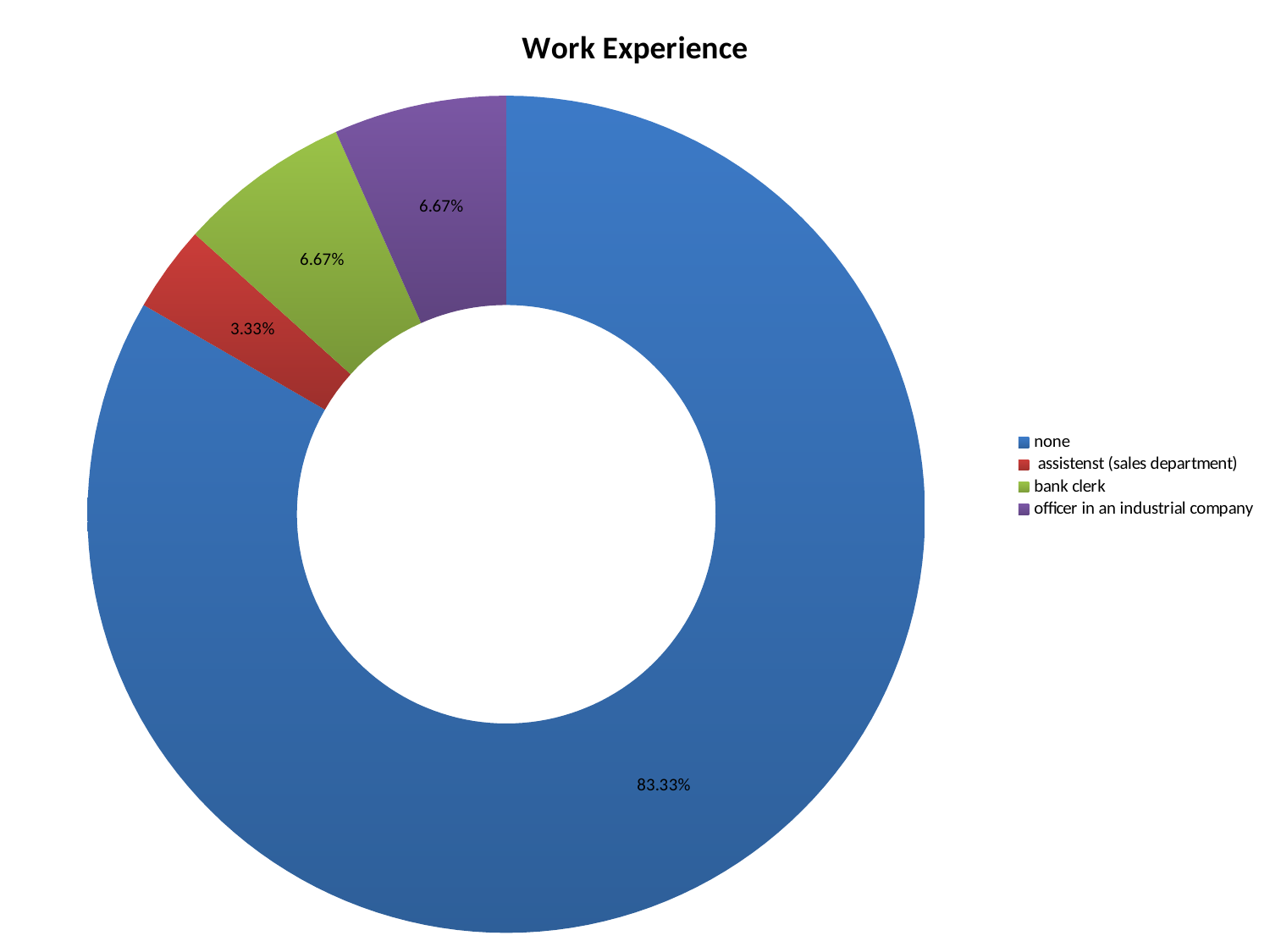
What kind of chart is shown on the slide? Doughnut chart What share of the chart does 'officer in an industrial company' represent? 6.67% What is the title of the chart? Work Experience How many categories does the legend list? 4 Which is larger, the share for 'bank clerk' or the share for 'assistenst (sales department)'? bank clerk What colour is the slice for 'officer in an industrial company'? Purple What share of the chart does the 'none' category represent? 83.33% What share of the chart does 'assistenst (sales department)' represent? 3.33% Which category has the smallest share? assistenst (sales department) What is the difference between the share for 'none' and the share for 'bank clerk'? 76.66% Which category has the largest share? none What share of the chart does 'bank clerk' represent? 6.67%